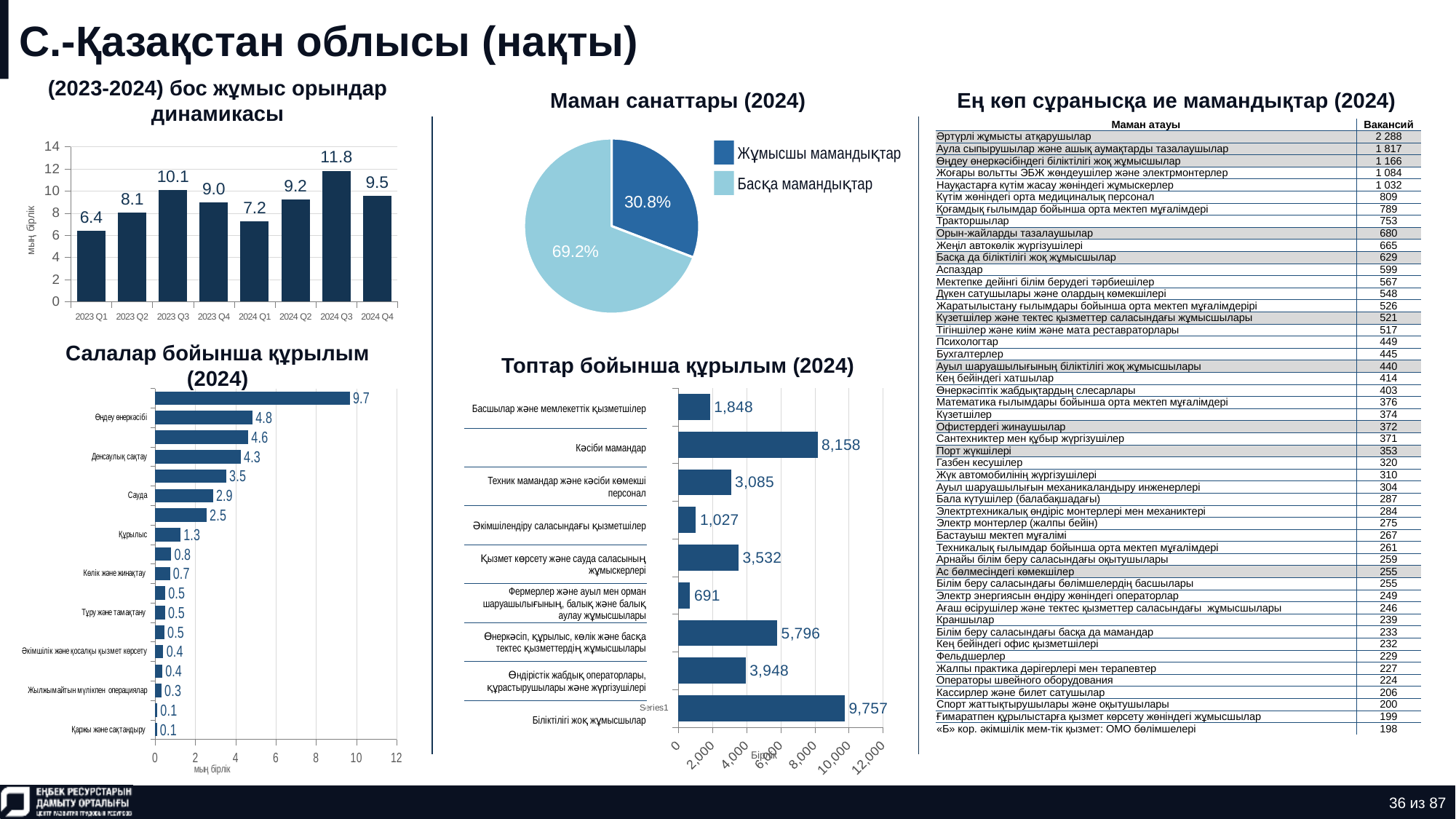
In the chart 'Топтар бойынша құрылым (2024)', which category has the highest value? Біліктілігі жоқ жұмысшылар In the chart 'Салалар бойынша құрылым (2024)', what is the largest value shown? 9.7 In the chart '(2023-2024) бос жұмыс орындар динамикасы', which is larger: 2023 Q4 or 2024 Q1? 2023 Q4 In the chart '(2023-2024) бос жұмыс орындар динамикасы', what is the value for 2024 Q3? 11.8 In the chart '(2023-2024) бос жұмыс орындар динамикасы', how many quarters are plotted? 8 In the chart '(2023-2024) бос жұмыс орындар динамикасы', which quarter has the lowest value? 2023 Q1 In the chart '(2023-2024) бос жұмыс орындар динамикасы', what is the difference between 2023 Q3 and 2023 Q1? 3.7 In the chart 'Топтар бойынша құрылым (2024)', what is the value for Кәсіби мамандар? 8,158 In the chart 'Топтар бойынша құрылым (2024)', what is the difference between Өндірістік жабдық операторлары, құрастырушылары және жүргізушілері and Әкімшілендіру саласындағы қызметшілер? 2,921 In the pie chart 'Маман санаттары (2024)', how many entries does the legend list? 2 In the pie chart 'Маман санаттары (2024)', what share is Жұмысшы мамандықтар? 30.8% What kind of chart is 'Салалар бойынша құрылым (2024)'? bar chart